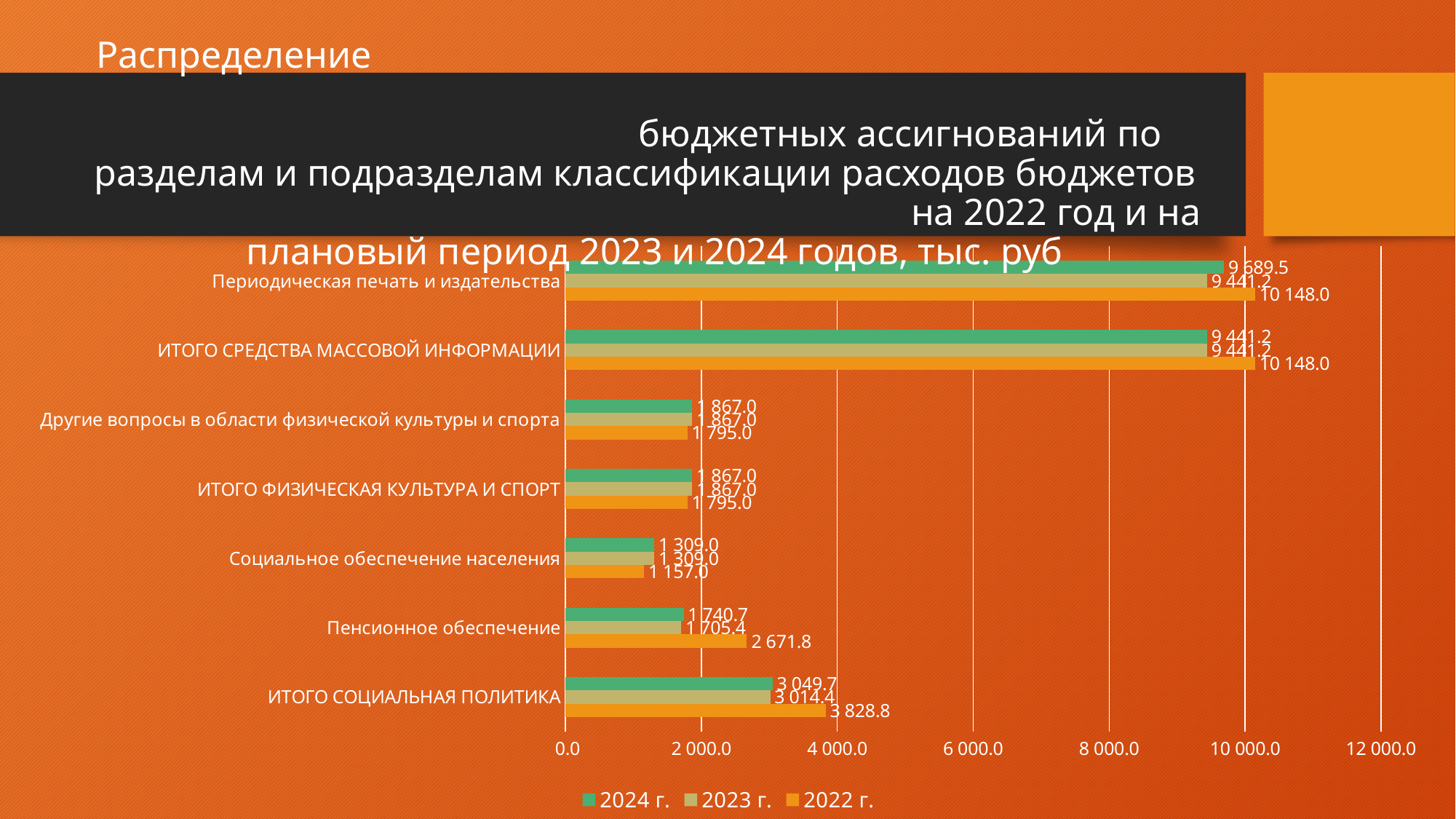
For Пенсионное обеспечение, which is larger: the 2022 г. value or the 2024 г. value? 2022 г. What is the value for ИТОГО СОЦИАЛЬНАЯ ПОЛИТИКА in the 2024 г. series? 3 049.7 Which category has the highest value in the 2024 г. series? Периодическая печать и издательства How many series does the legend list? 3 What kind of chart is shown on the slide? bar chart Which series is shown in green in the legend? 2024 г. What is the difference between the 2022 г. and 2024 г. values for ИТОГО СОЦИАЛЬНАЯ ПОЛИТИКА? 779.1 How many categories are shown on the chart? 7 What is the value for Социальное обеспечение населения in the 2023 г. series? 1 309.0 What is the value for Периодическая печать и издательства in the 2022 г. series? 10 148.0 Which category has the lowest value in the 2022 г. series? Социальное обеспечение населения What is the value for Пенсионное обеспечение in the 2022 г. series? 2 671.8